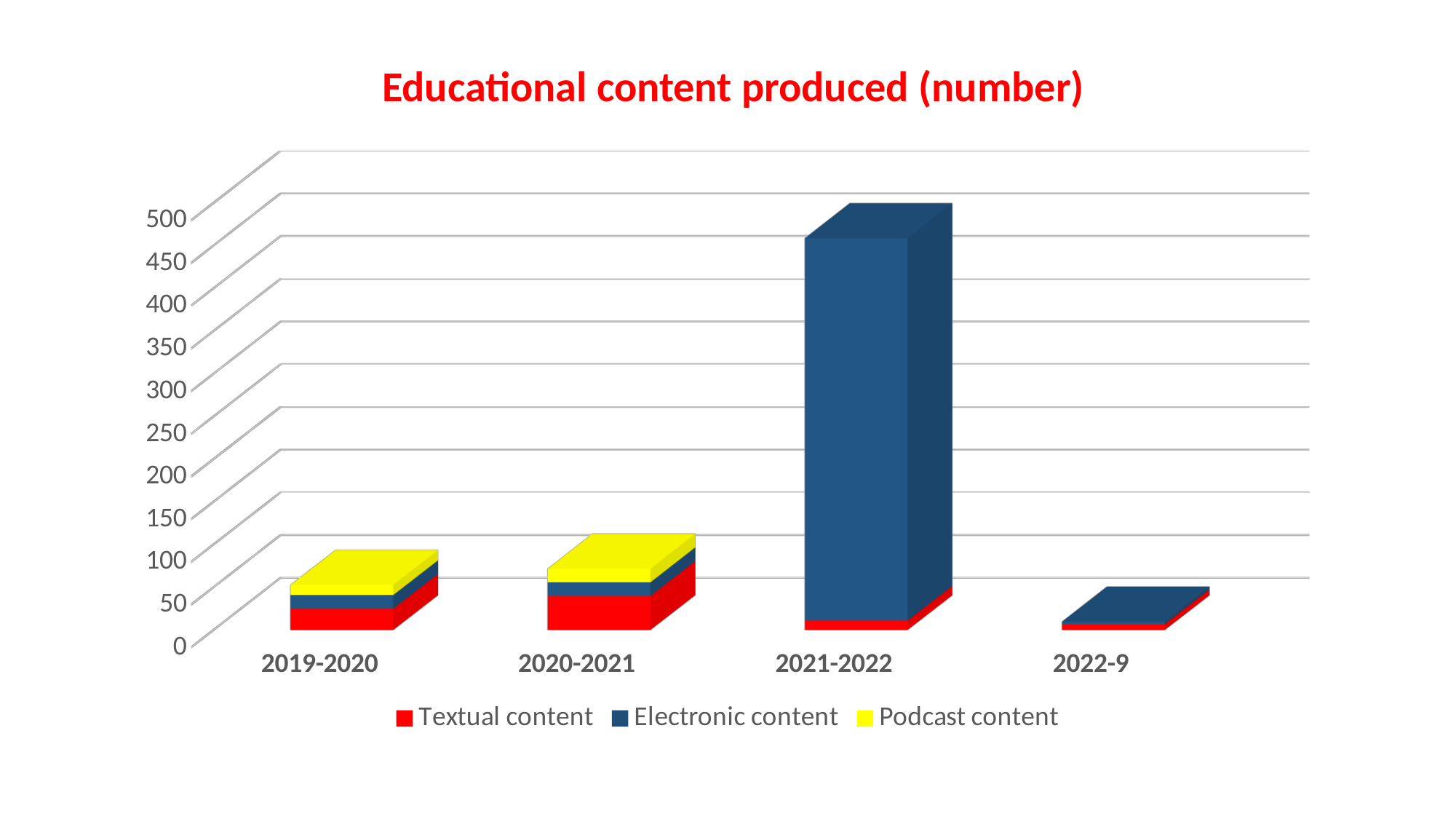
Is the total value for 2021-2022 greater or less than 400? greater Which series is shown in yellow in the legend? Podcast content Is the total value for 2022-9 greater or less than 50? less How many series does the legend list? 3 What is the title of the chart? Educational content produced (number) Is the total value for 2019-2020 greater or less than 100? less Which has the larger total bar, 2019-2020 or 2020-2021? 2020-2021 Which category has the highest total bar? 2021-2022 What type of chart is shown on the slide? Bar chart Which category has the lowest total bar? 2022-9 How many categories are shown on the x axis? 4